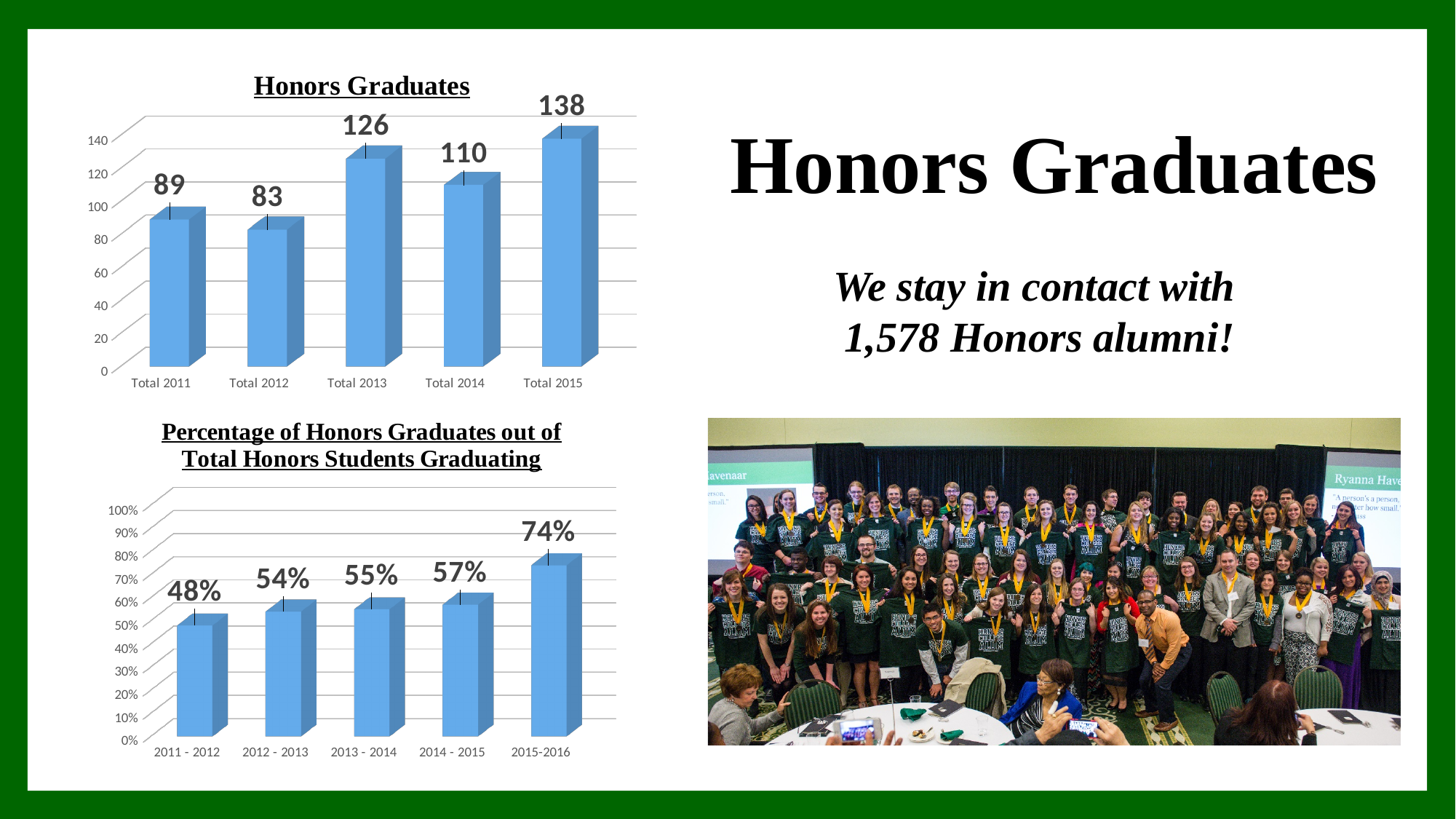
What is the title of the bottom-left chart on the slide? Percentage of Honors Graduates out of Total Honors Students Graduating In the 'Percentage of Honors Graduates out of Total Honors Students Graduating' chart, what is the value for 2015-2016? 74% In the 'Percentage of Honors Graduates out of Total Honors Students Graduating' chart, do the values rise or fall from 2011 - 2012 to 2015-2016? Rise In the 'Honors Graduates' chart, what is the difference between the values for Total 2015 and Total 2011? 49 In the 'Percentage of Honors Graduates out of Total Honors Students Graduating' chart, what is the difference between the values for 2015-2016 and 2014 - 2015? 17% In the 'Honors Graduates' chart, which category has the highest value? Total 2015 In the 'Honors Graduates' chart, which is larger, the value for Total 2013 or Total 2014? Total 2013 In the 'Percentage of Honors Graduates out of Total Honors Students Graduating' chart, which category has the lowest value? 2011 - 2012 In the 'Honors Graduates' chart, how many categories are shown? 5 What kind of chart is the 'Honors Graduates' chart? Bar chart In the 'Honors Graduates' chart, what is the value for Total 2013? 126 In the 'Honors Graduates' chart, which category has the lowest value? Total 2012